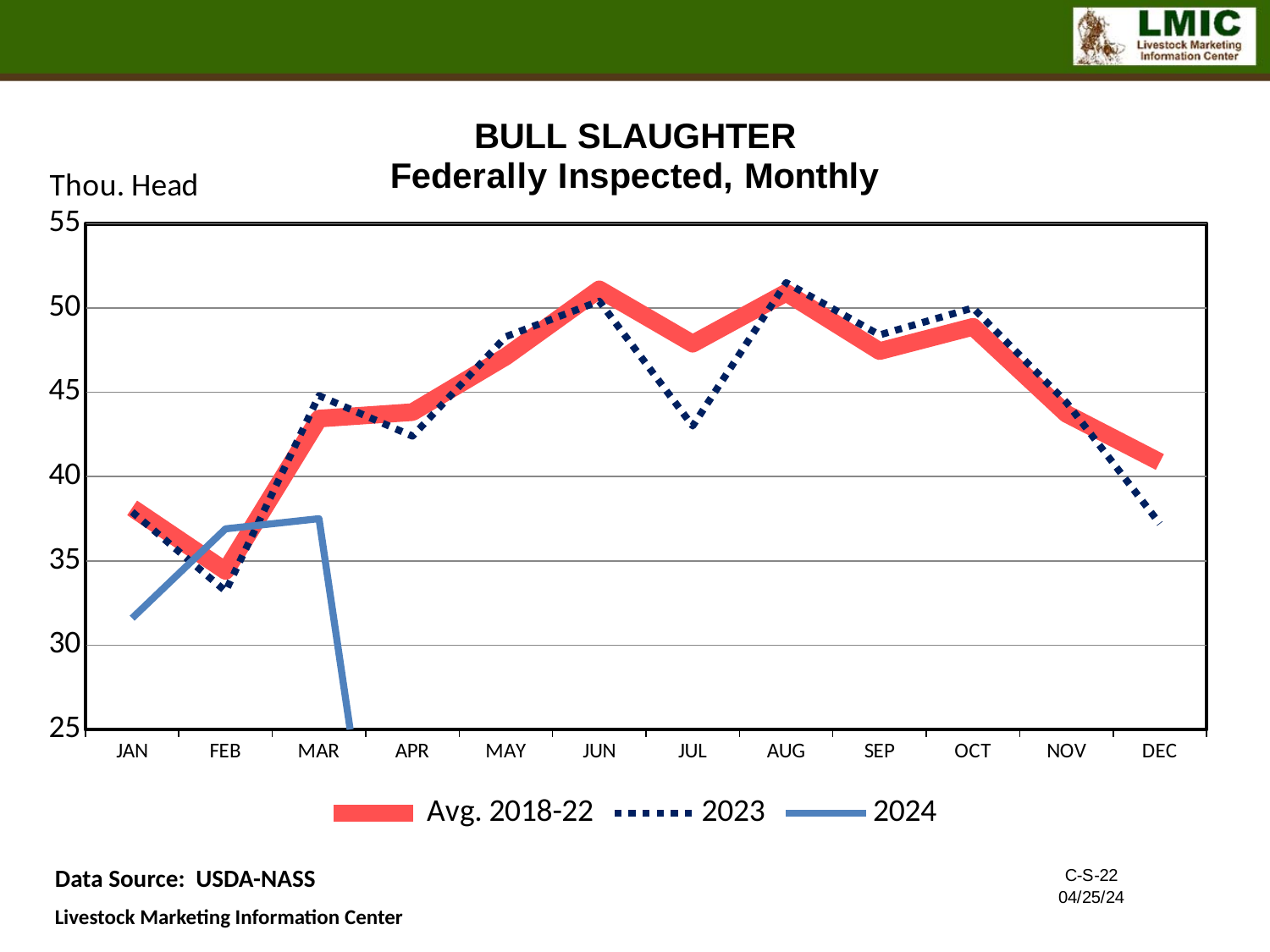
In JUL, which is larger: the 2023 value or the Avg. 2018-22 value? Avg. 2018-22 In FEB, which is larger: the 2024 value or the 2023 value? 2024 How many months are shown along the x axis? 12 In which month is the Avg. 2018-22 series at its lowest? FEB What kind of chart is shown on the slide? line chart Is the 2023 value for DEC greater or less than 40? less In which month is the 2023 series at its lowest? FEB Is the Avg. 2018-22 value for JUN greater or less than 50? greater Does the Avg. 2018-22 series rise or fall from OCT to DEC? fall How many series does the legend list? 3 Is the 2023 value for JUL greater or less than 45? less